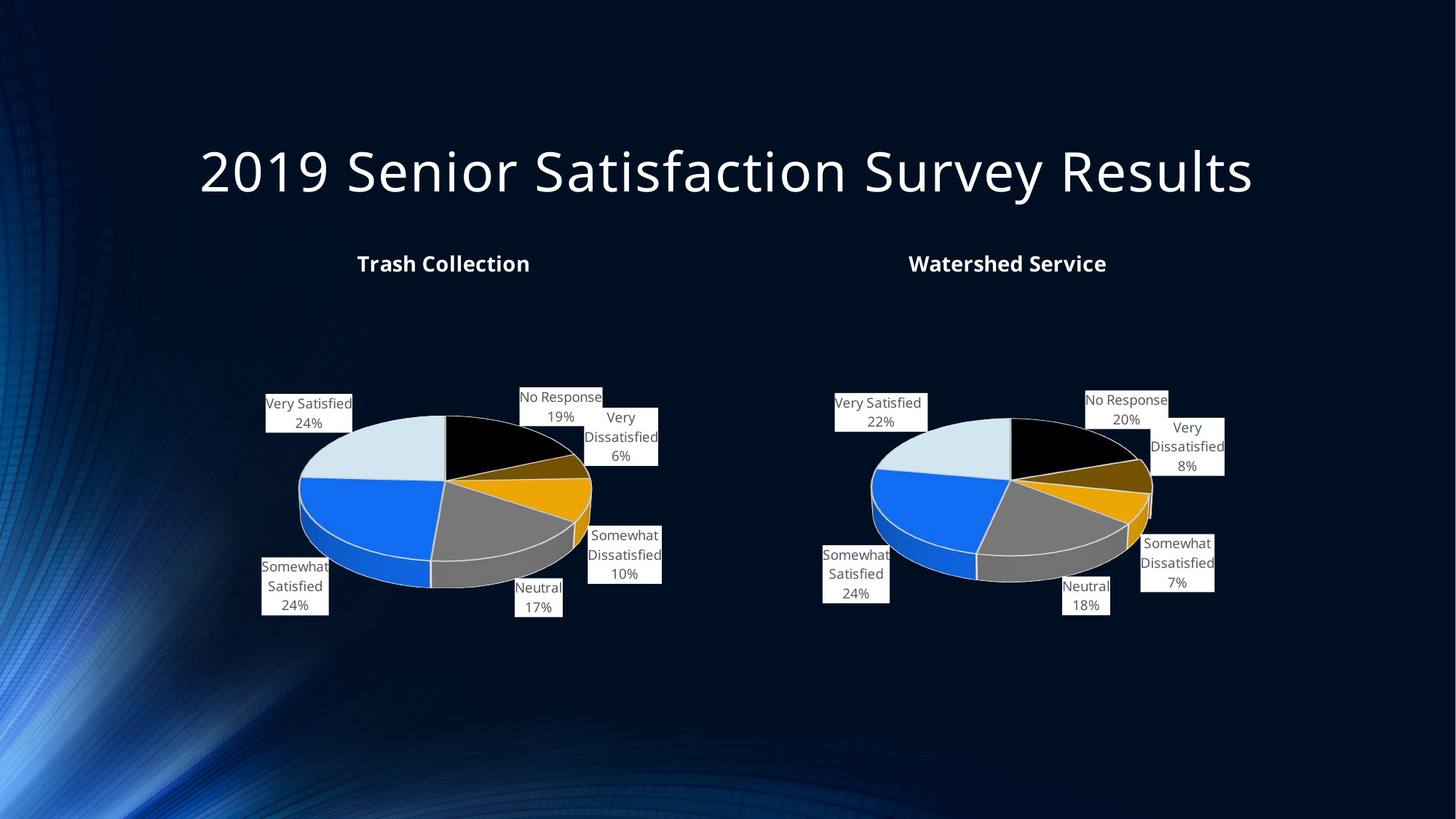
In the Trash Collection chart, which category has the smallest share? Very Dissatisfied In the Trash Collection chart, what is the share for Somewhat Dissatisfied? 10% In the Trash Collection chart, what is the difference between the Neutral share and the Very Dissatisfied share? 11% What type of chart is the Watershed Service chart? Pie chart In the Watershed Service chart, which category has the smallest share? Somewhat Dissatisfied In the Watershed Service chart, which category has the largest share? Somewhat Satisfied In the Watershed Service chart, what percentage of respondents gave No Response? 20% In the Watershed Service chart, what is the share for Neutral? 18% Which chart has the larger Very Dissatisfied share, Trash Collection or Watershed Service? Watershed Service In the Watershed Service chart, what is the difference between the Very Satisfied share and the Very Dissatisfied share? 14% In the Trash Collection chart, what percentage of respondents were Very Satisfied? 24% How many categories does the Trash Collection chart show? 6